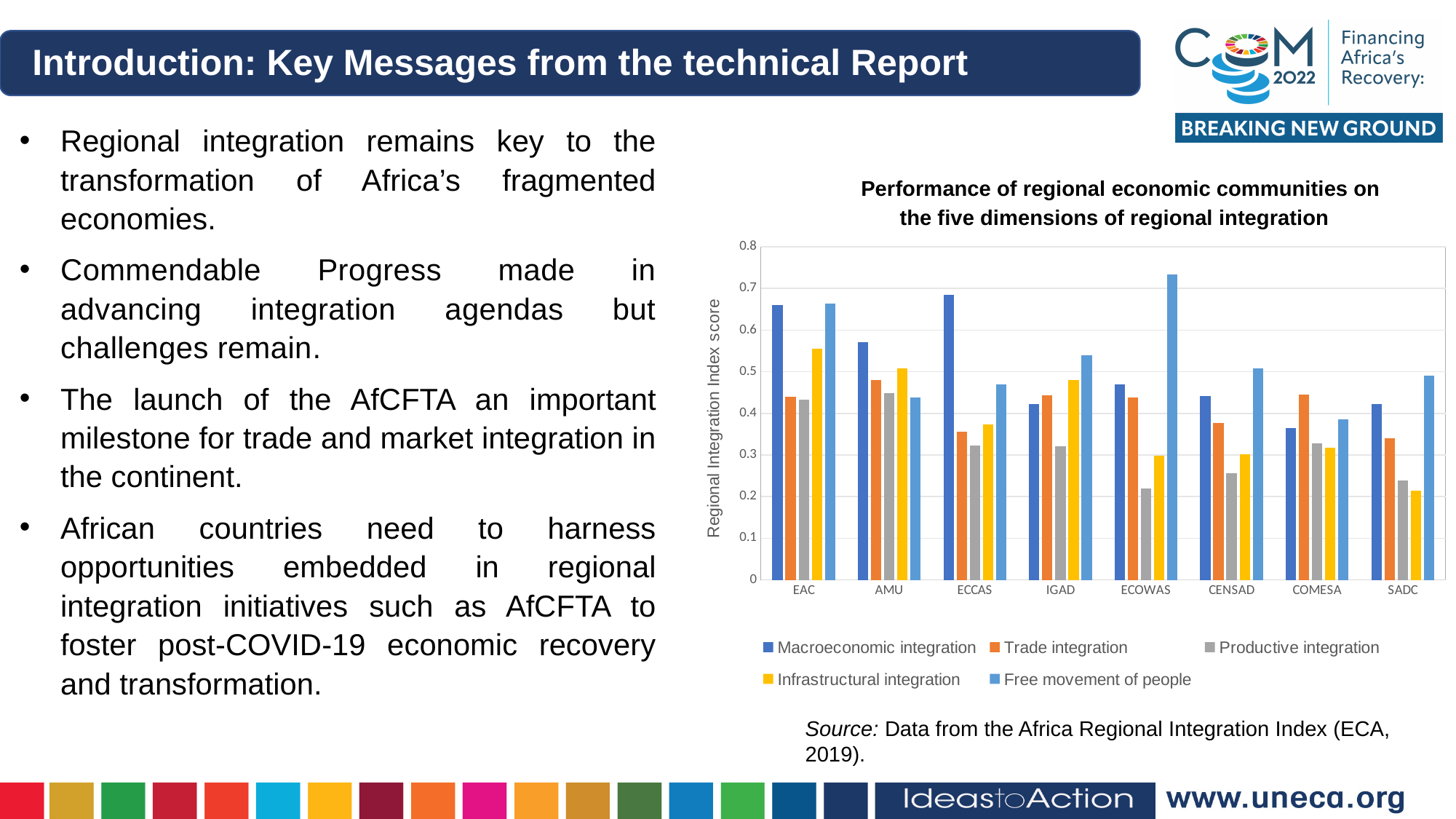
Which regional economic community has the lowest Macroeconomic integration score? COMESA Is the Infrastructural integration score for EAC greater or less than 0.5? greater For IGAD, which is larger: the Free movement of people score or the Macroeconomic integration score? Free movement of people Is the Free movement of people score for ECOWAS greater or less than 0.7? greater What kind of chart is shown on the slide? Bar chart For ECCAS, which is larger: the Macroeconomic integration score or the Trade integration score? Macroeconomic integration How many regional economic communities are shown on the x axis of the chart? 8 How many series does the chart's legend list? 5 Is the Productive integration score for ECOWAS greater or less than 0.3? less What is the label on the vertical axis of the chart? Regional Integration Index score Which regional economic community has the lowest Infrastructural integration score? SADC Which regional economic community has the highest Free movement of people score? ECOWAS